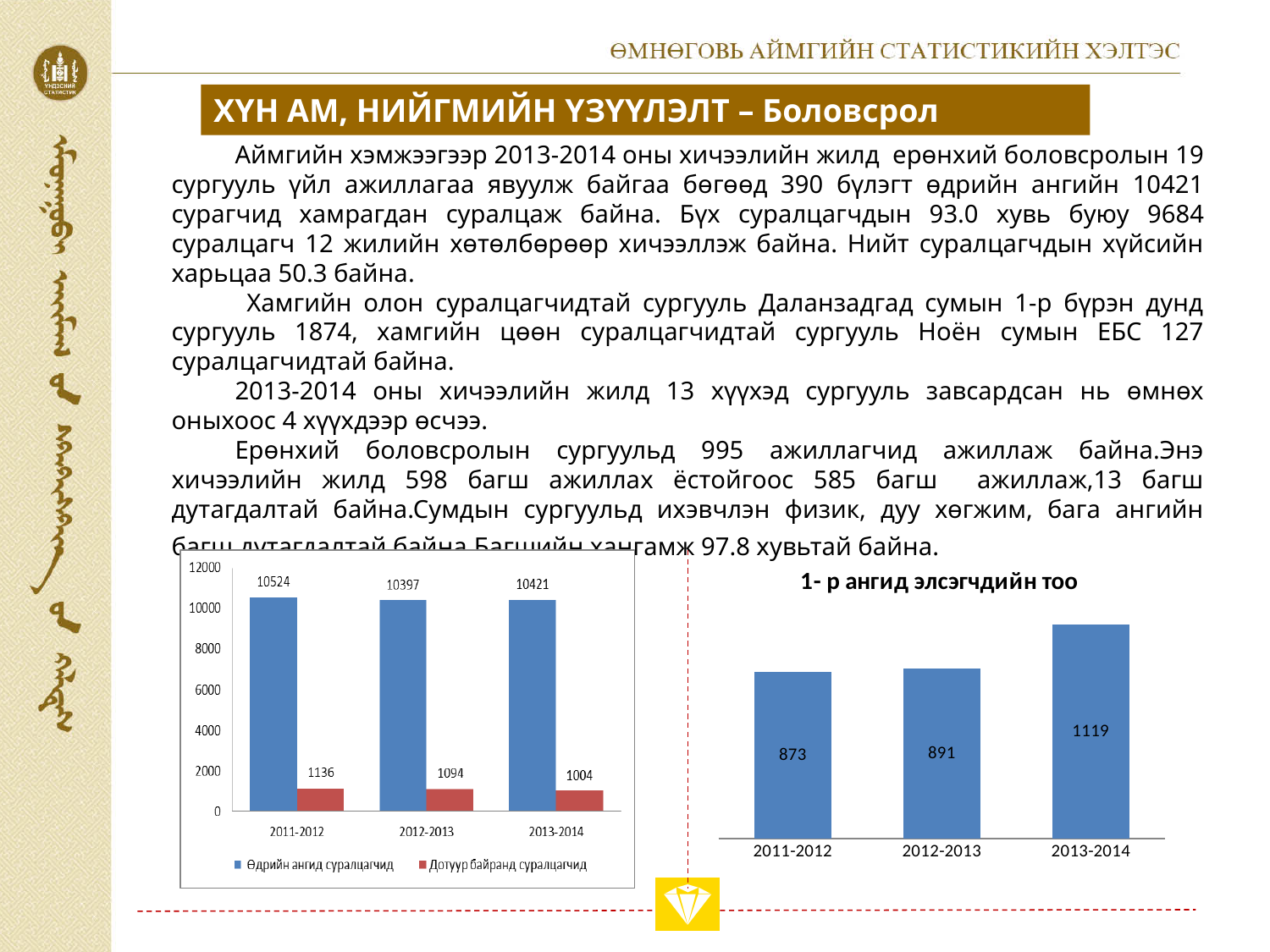
In the left chart, what is the value for Өдрийн ангид суралцагчид in 2011-2012? 10524 In the chart titled '1- р ангид элсэгчдийн тоо', what is the value for 2013-2014? 1119 In the left chart, do the values for Дотуур байранд суралцагчид rise or fall from 2011-2012 to 2013-2014? fall In the left chart, what is the difference between Дотуур байранд суралцагчид in 2011-2012 and 2013-2014? 132 In the left chart, which year has the highest value for Өдрийн ангид суралцагчид? 2011-2012 In the left chart, how many series does the legend list? 2 In the left chart, which year has the lowest value for Дотуур байранд суралцагчид? 2013-2014 In the chart titled '1- р ангид элсэгчдийн тоо', how many categories are shown on the x axis? 3 In the left chart, what is the value for Дотуур байранд суралцагчид in 2013-2014? 1004 What kind of chart is the chart titled '1- р ангид элсэгчдийн тоо'? bar chart In the chart titled '1- р ангид элсэгчдийн тоо', which year has the lowest value? 2011-2012 In the chart titled '1- р ангид элсэгчдийн тоо', what is the difference between 2013-2014 and 2012-2013? 228